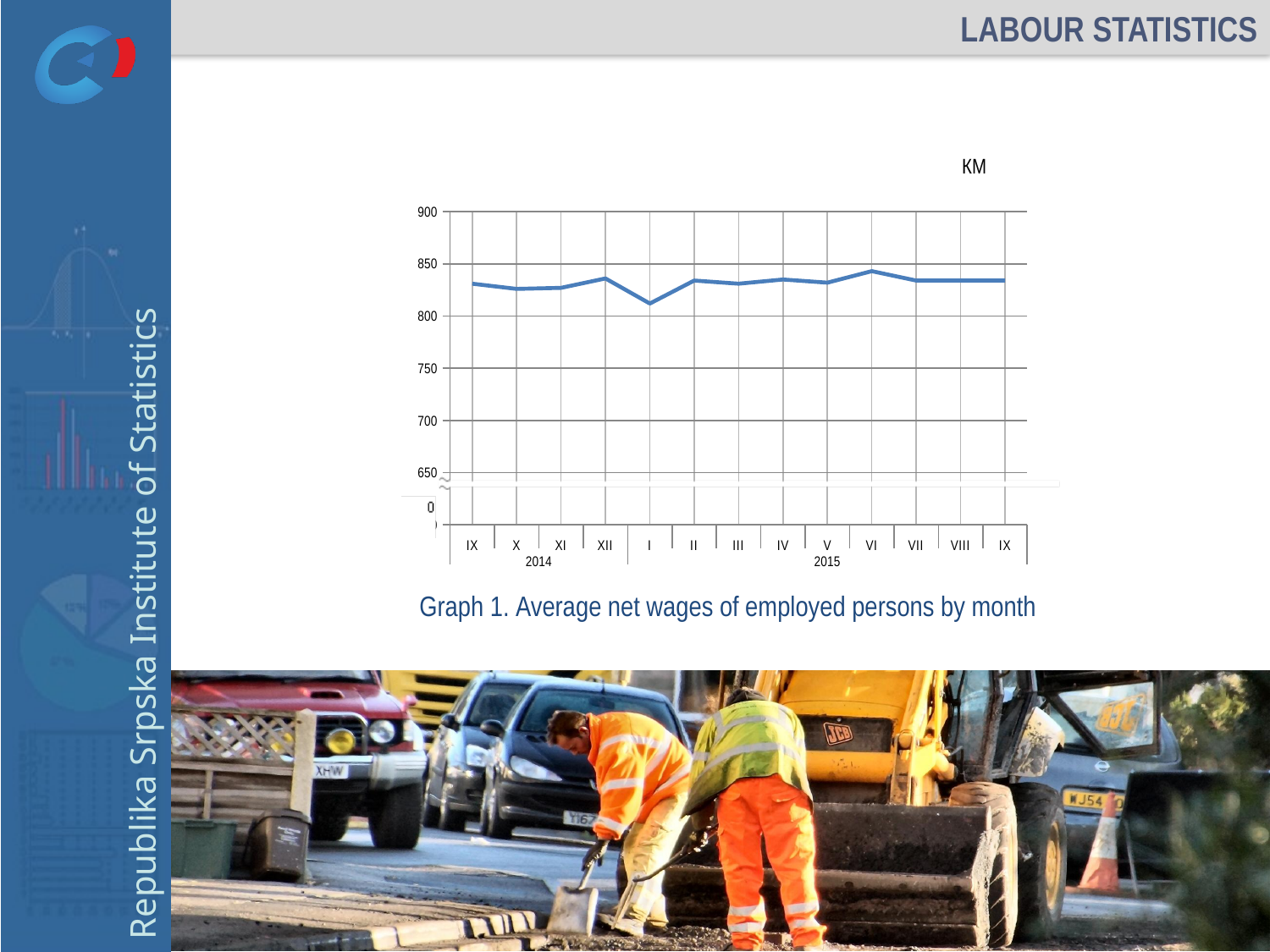
How many monthly points are plotted on the line? 13 Which is larger, the value for VI 2015 or the value for X 2014? VI 2015 Which is larger, the value for XII 2014 or the value for I 2015? XII 2014 What kind of chart is Graph 1? line chart Is the value for VI 2015 greater or less than 850? less Which month has the highest average net wage on the chart? VI 2015 Which month has the lowest average net wage on the chart? I 2015 Is the value for I 2015 greater or less than 850? less What unit is shown above the chart? KM What is the title of the chart on the slide? Graph 1. Average net wages of employed persons by month Is the value for I 2015 greater or less than 800? greater